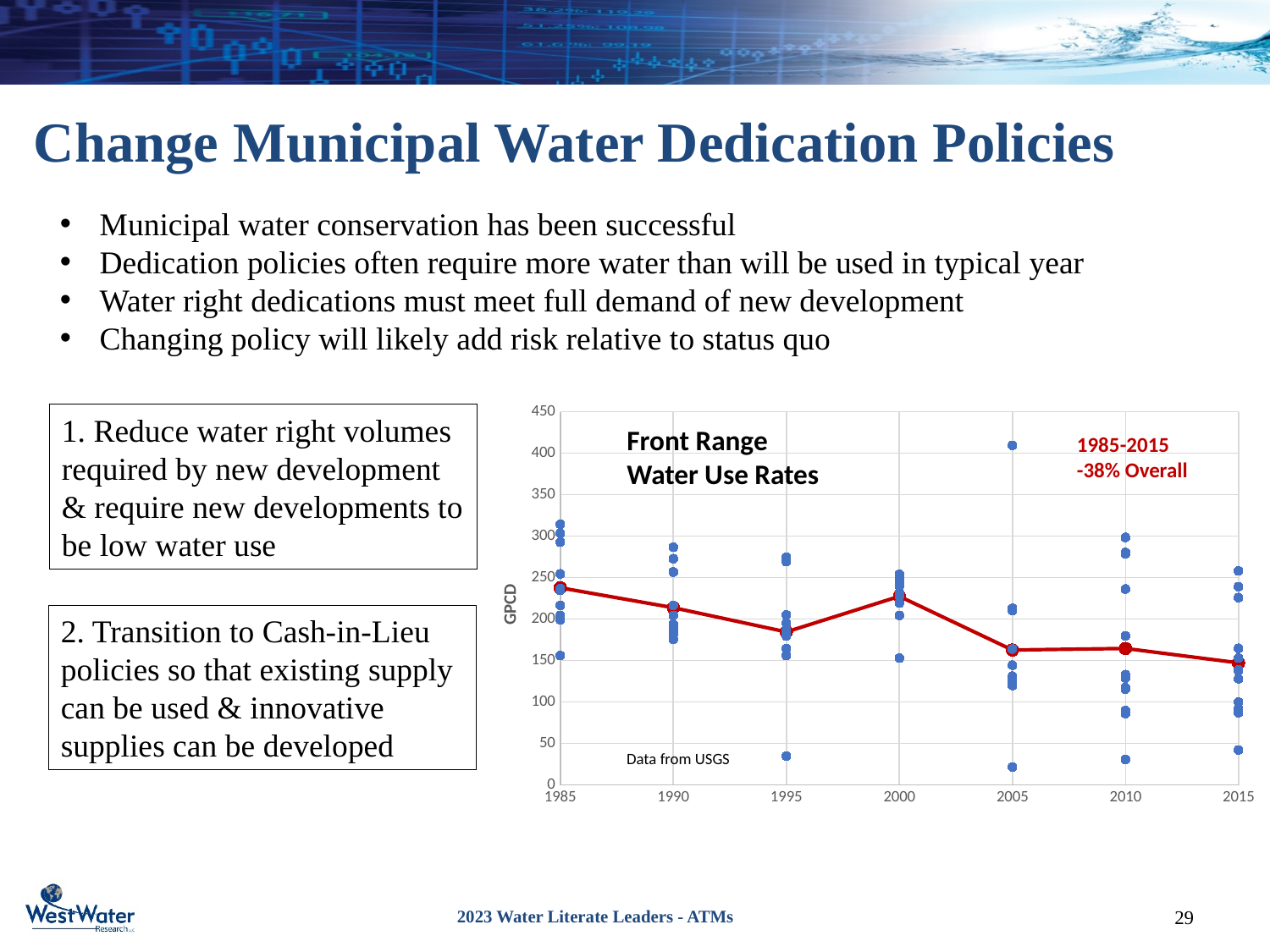
Does the red line in the chart generally rise or fall from 1985 to 2015? Fall How many years are labeled on the horizontal axis of the chart? 7 Which year has the lowest red line value? 2015 Is the red line value for 2000 greater or less than 200 GPCD? greater Is the red line value larger in 1985 or in 2015? 1985 What is the label on the vertical axis of the chart? GPCD What kind of chart is shown on the slide? Scatter plot with a line Is the red line value for 2015 greater or less than 200 GPCD? less What is the title of the chart? Front Range Water Use Rates Which year has the highest red line value? 1985 Is the red line value for 2005 greater or less than 200 GPCD? less